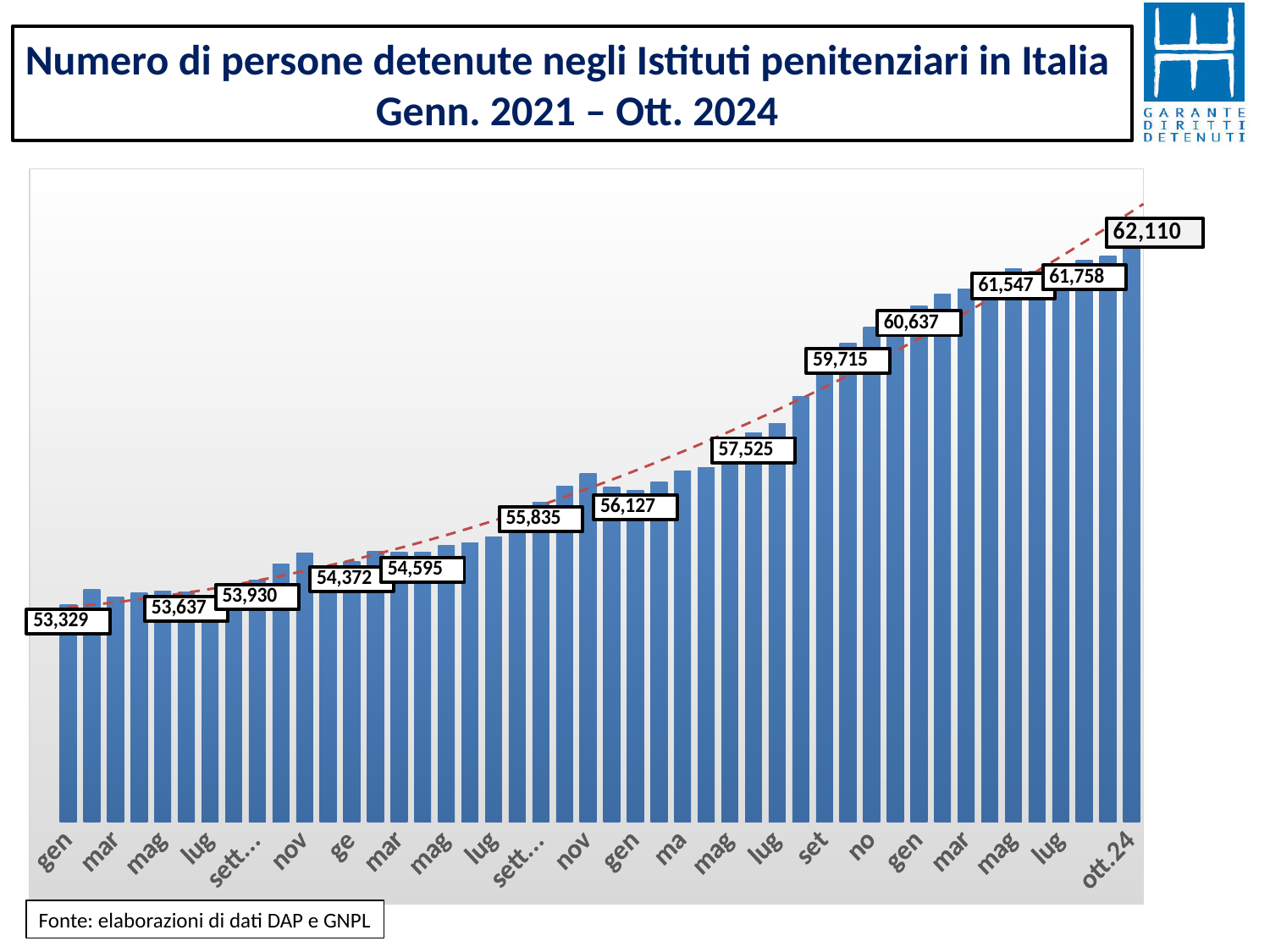
What source is cited at the bottom of the slide? Fonte: elaborazioni di dati DAP e GNPL What is the difference between the labelled values 62,110 and 61,758? 352 What is the number of detained persons shown for ott.24? 62,110 Do the values generally rise or fall from left to right along the x axis? rise What is the difference between the value for ott.24 (62,110) and the first bar (53,329)? 8,781 How many data labels with values are printed on the chart? 13 Which month has the highest value in the chart? ott.24 What is the title of the chart on the slide? Numero di persone detenute negli Istituti penitenziari in Italia Genn. 2021 – Ott. 2024 What kind of chart is shown on the slide? bar chart Which bar has the lowest value in the chart? lug (July 2021) What value is labelled on the first bar (gen 2021)? 53,329 Which is larger, the value labelled 61,758 or the value labelled 62,110? 62,110